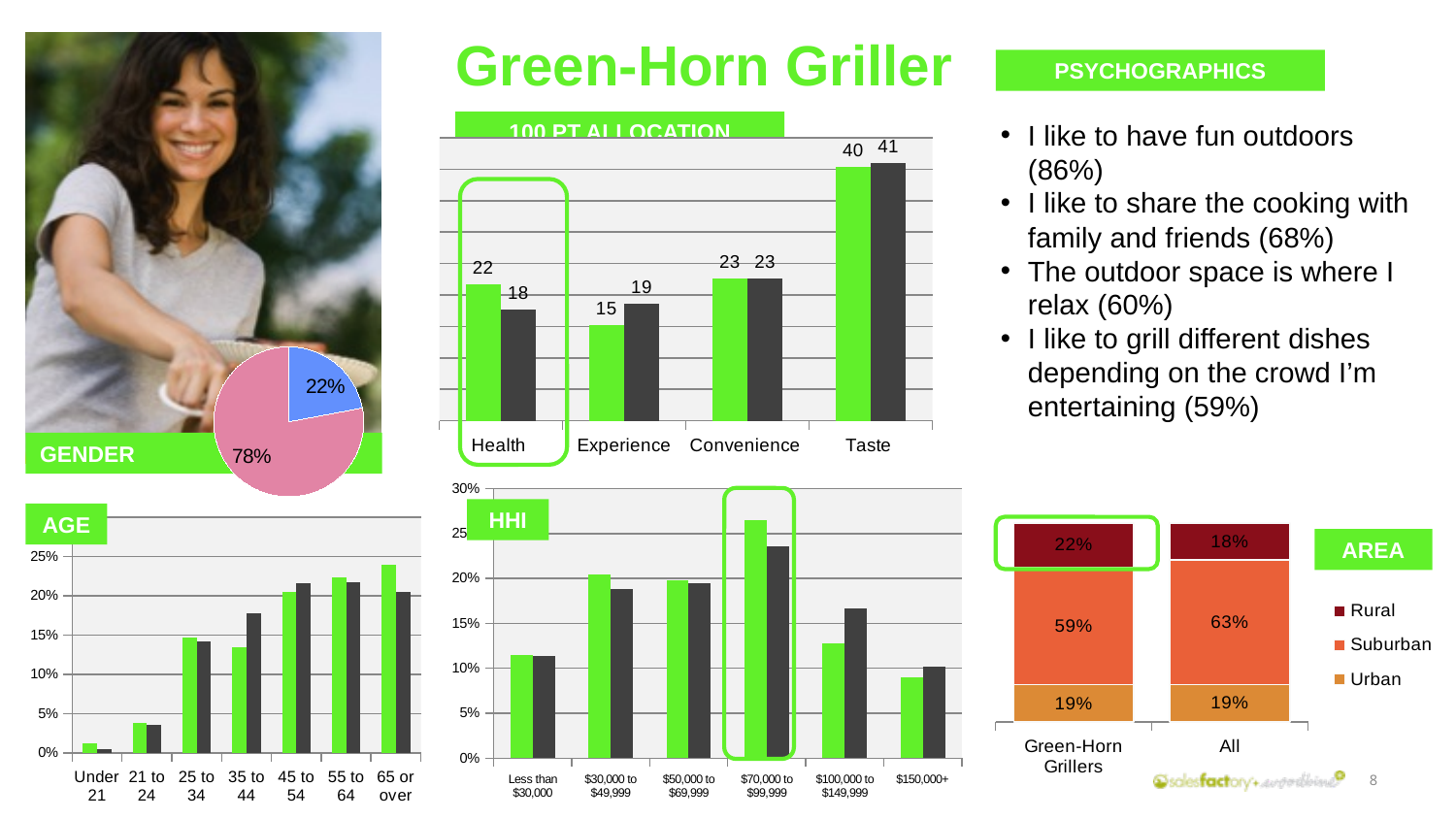
What kind of chart is the Age chart? bar chart In the Area chart, how many series does the legend list? 3 In the 100 PT Allocation chart, how many categories are shown on the x axis? 4 In the Area chart, what is the Rural percentage for Green-Horn Grillers? 22% In the 100 PT Allocation chart, what is the difference between the green bar for Taste and the green bar for Health? 18 In the 100 PT Allocation chart, what is the value of the green bar for Taste? 40 In the Area chart, what is the Suburban percentage for All? 63% In the HHI chart, is the green bar for $70,000 to $99,999 greater or less than 25%? greater In the Age chart, is the green bar for 65 or over greater or less than 20%? greater In the 100 PT Allocation chart, which category has the highest values? Taste In the 100 PT Allocation chart, what is the value of the dark grey bar for Health? 18 In the Gender pie chart, what share does the larger slice represent? 78%